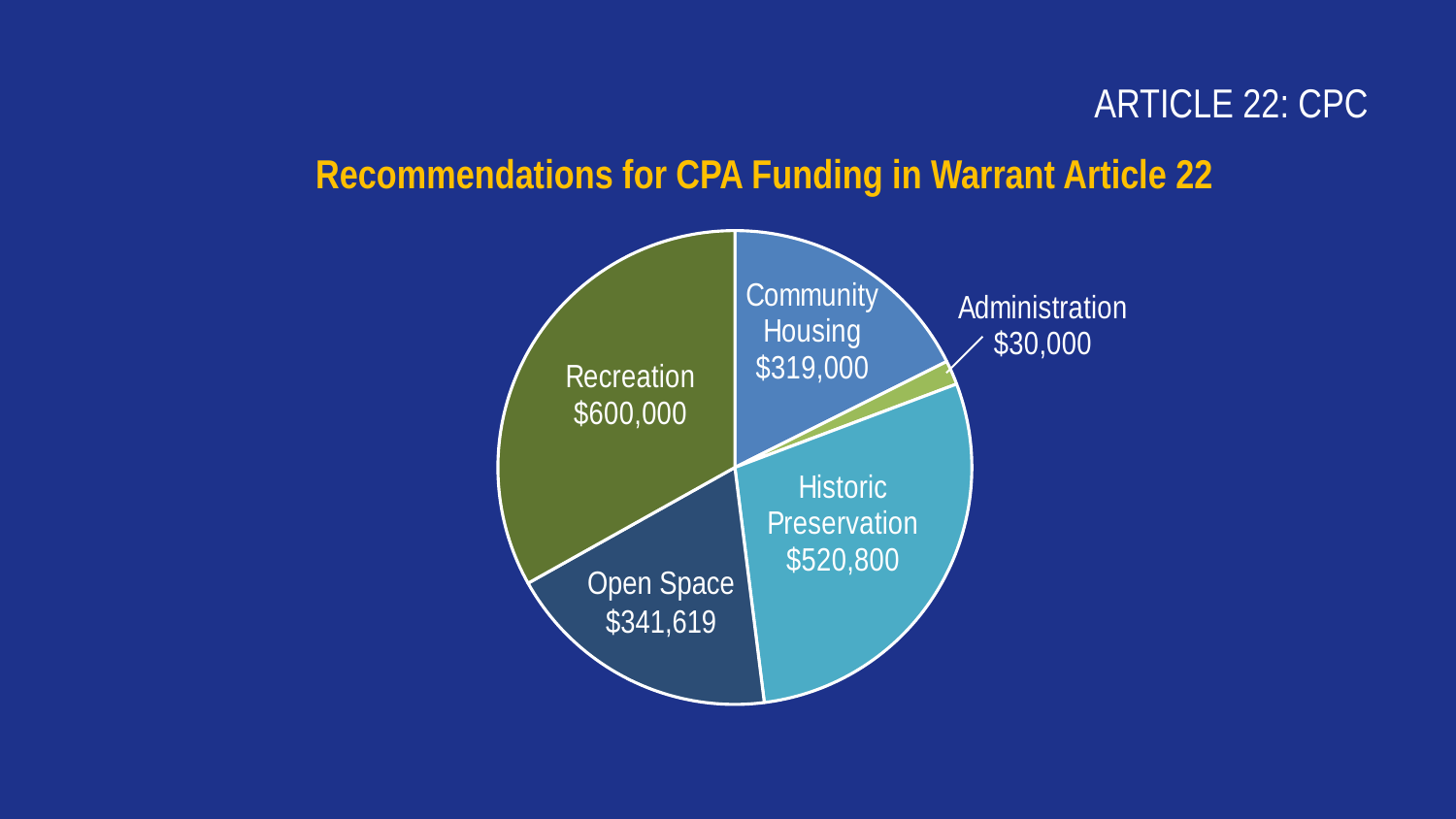
How many categories are shown in the pie chart? 5 What is the difference between the Historic Preservation and Community Housing values? $201,800 Which category has the largest slice of the pie? Recreation What kind of chart is shown on the slide? Pie chart What is the title of the chart? Recommendations for CPA Funding in Warrant Article 22 What is the difference between the Recreation and Historic Preservation values? $79,200 Which is larger, Open Space or Community Housing? Open Space What is the value for Historic Preservation? $520,800 What is the value for Open Space? $341,619 What is the value for Administration? $30,000 Which category has the smallest slice of the pie? Administration What is the value for Recreation? $600,000